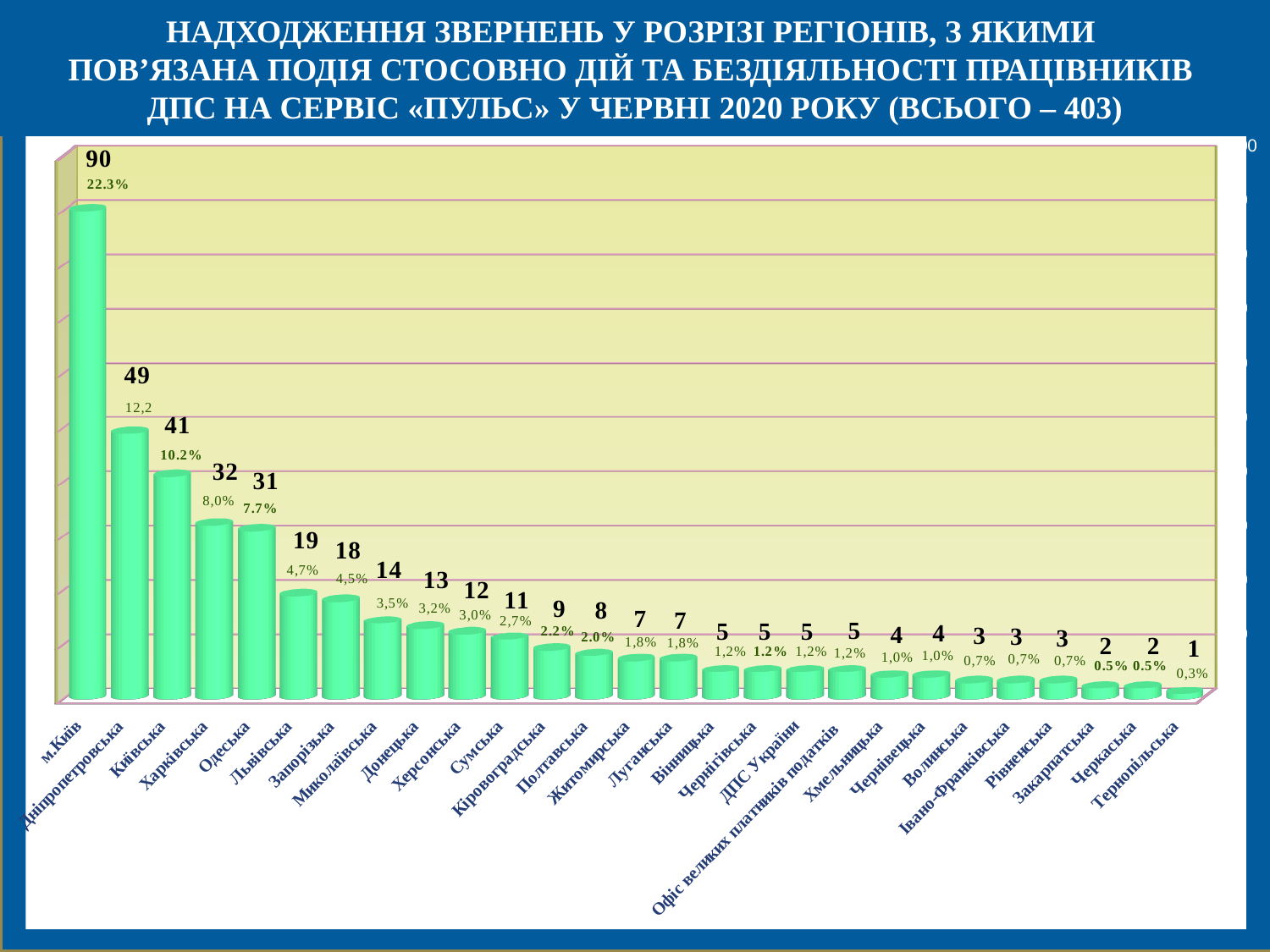
What kind of chart is this? bar chart Which is larger, the value for Одеська or the value for Запорізька? Одеська What is the difference between the values for Київська and Харківська? 9 How many categories are shown on the x axis? 27 What percentage share is shown for Київська? 10.2% Do the values rise or fall from left to right along the x axis? fall What is the value for Львівська? 19 Which region has the lowest value? Тернопільська What is the value for м.Київ? 90 What is the difference between the values for м.Київ and Дніпропетровська? 41 Which region has the highest value? м.Київ What is the value for Дніпропетровська? 49